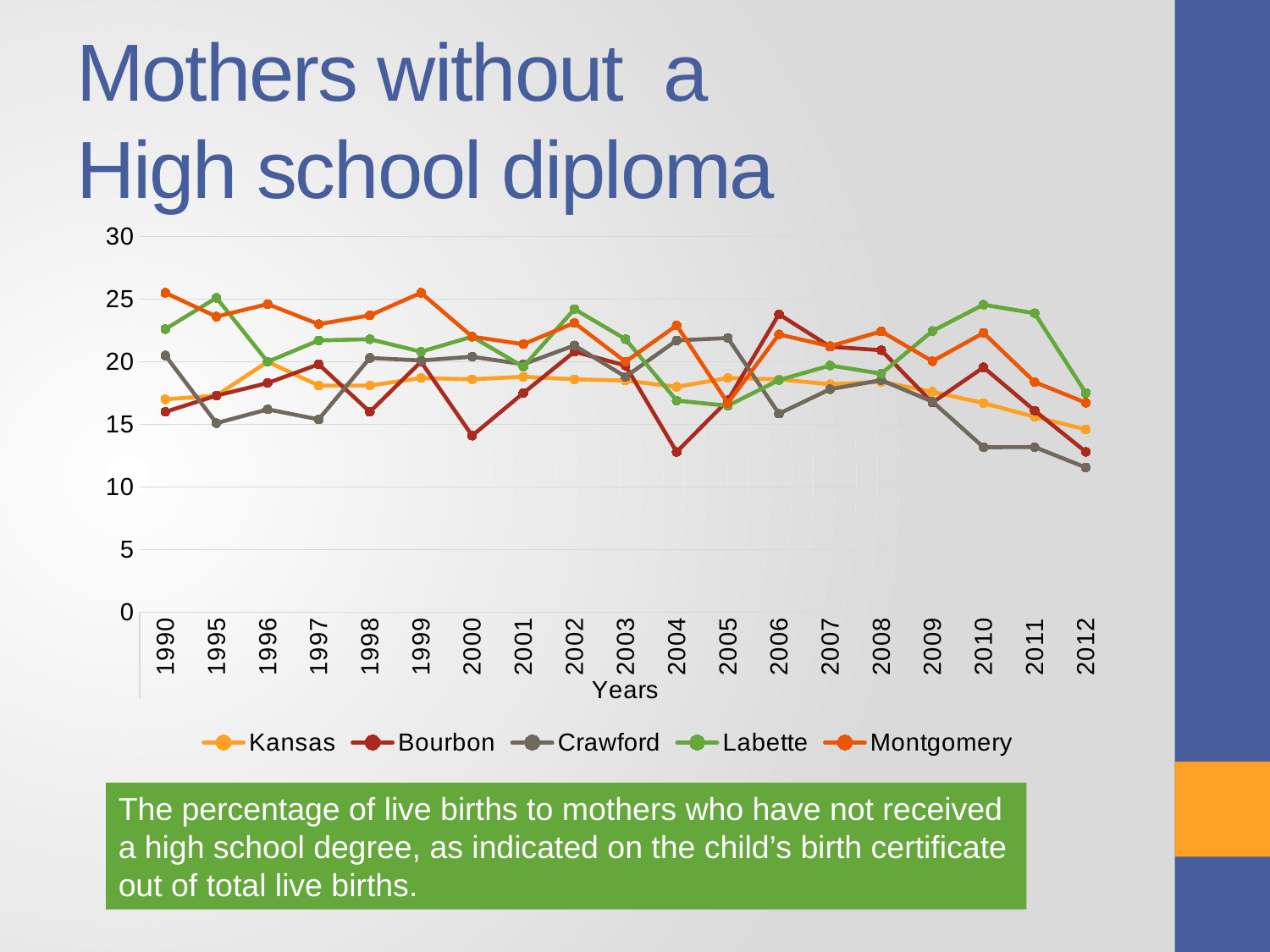
What colour is the Labette line in the legend? green What kind of chart is shown on the slide? line chart Which series has the lowest value in 2012? Crawford In 2006, which is larger, the value for Bourbon or the value for Crawford? Bourbon Does the Kansas line rise or fall from 2008 to 2012? fall Is the value for Crawford in 2012 greater or less than 15? less Is the value for Bourbon in 2004 greater or less than 15? less How many series does the legend list? 5 Is the value for Montgomery in 1990 greater or less than 25? greater What is the title of the x axis? Years Which series has the highest value in 1990? Montgomery How many years are shown along the x axis? 19